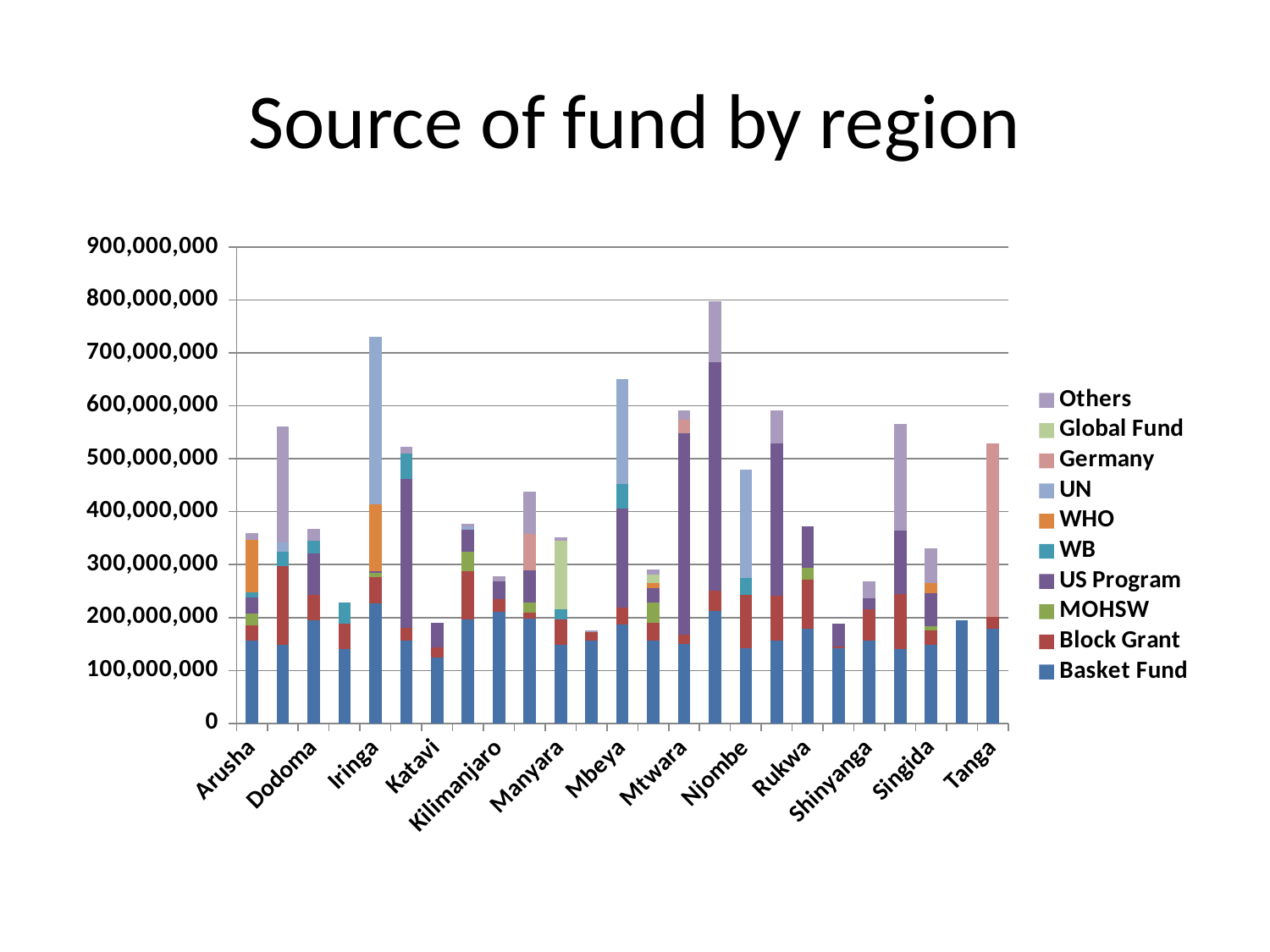
Is the total bar for Iringa greater or less than 700,000,000? greater Is the total bar for Tanga greater or less than 500,000,000? greater Is the total bar for Shinyanga greater or less than 200,000,000? greater What kind of chart is shown on the slide? Stacked bar chart How many series does the legend list? 10 What is the title of the chart? Source of fund by region Which region has the taller total bar, Iringa or Katavi? Iringa Which region has the taller total bar, Mbeya or Dodoma? Mbeya Which series forms the bottom segment of each stacked bar? Basket Fund